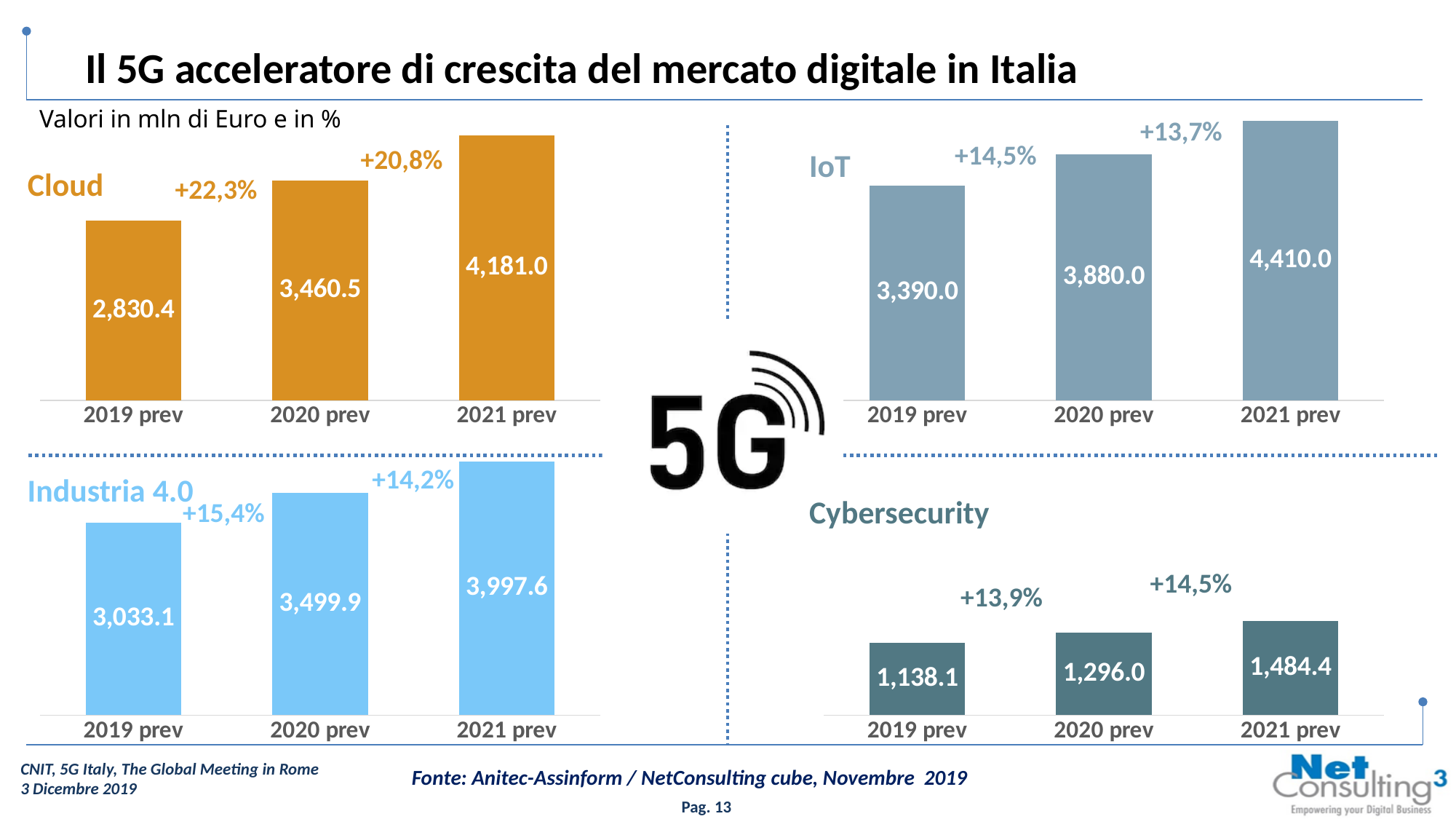
In the Cybersecurity chart, what is the difference between the 2020 prev and 2019 prev values? 157.9 In the Cloud chart, what is the difference between the 2021 prev and 2019 prev values? 1,350.6 In the Cloud chart, what growth percentage is shown above the 2020 prev bar? +22,3% In the Cybersecurity chart, what is the value for 2021 prev? 1,484.4 In the IoT chart, which year has the highest value? 2021 prev In the IoT chart, what is the value for 2019 prev? 3,390.0 In the Industria 4.0 chart, what is the value for 2020 prev? 3,499.9 Do the values in the Cybersecurity chart rise or fall from 2019 prev to 2021 prev? rise In the Cloud chart, what is the value for 2021 prev? 4,181.0 How many bars does the Industria 4.0 chart have? 3 In the Cybersecurity chart, which year has the lowest value? 2019 prev Which is larger: the 2021 prev value in the IoT chart or the 2021 prev value in the Industria 4.0 chart? IoT